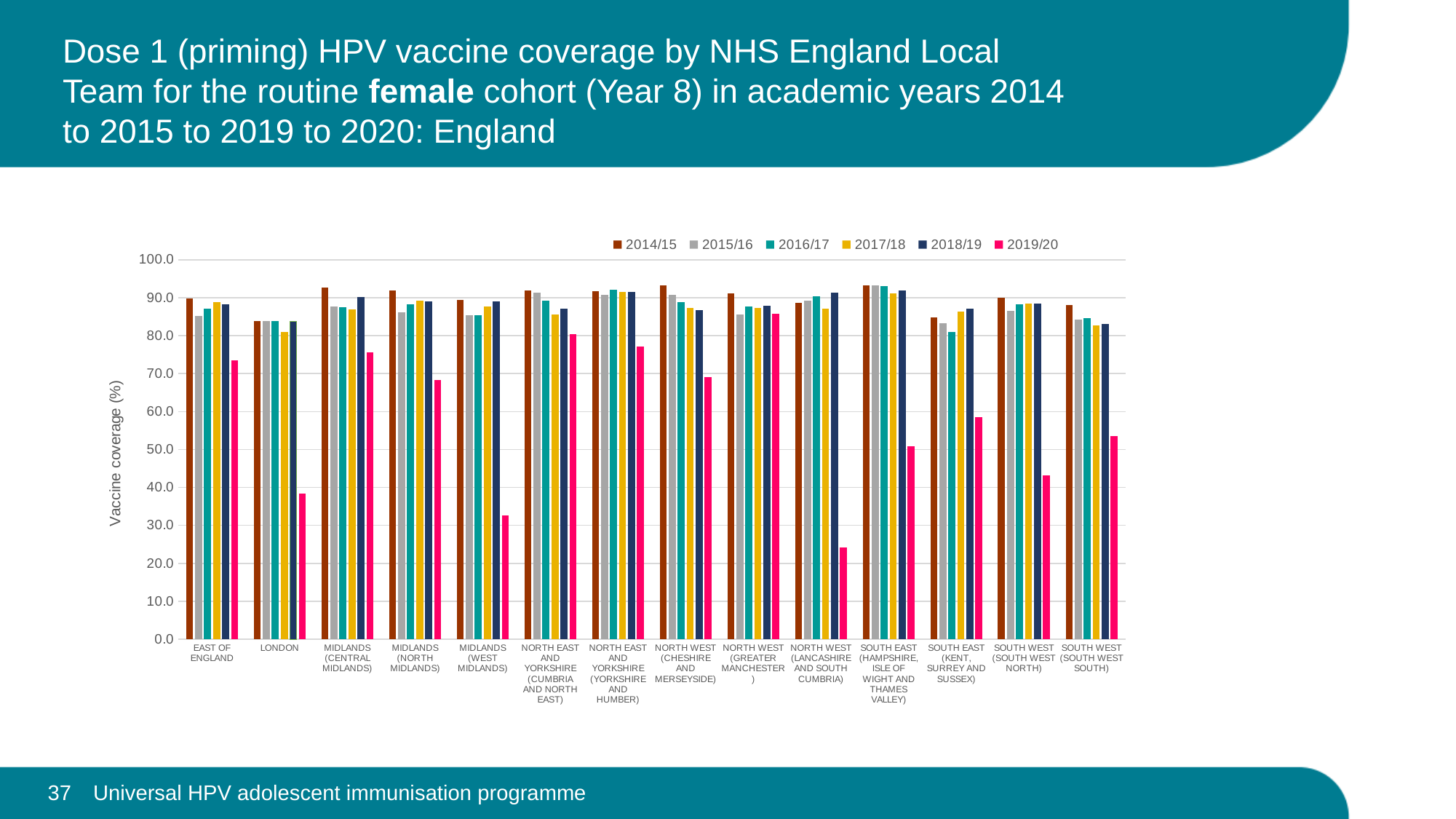
Which is larger for 2019/20: East of England or London? East of England How many NHS England Local Teams are shown along the x axis? 14 Is the 2019/20 value for Midlands (West Midlands) greater or less than 40? less What kind of chart is shown on the slide? bar chart Is the 2019/20 value for London greater or less than 50? less Which Local Team has the highest 2019/20 value? North West (Greater Manchester) Is the 2019/20 value for North West (Lancashire and South Cumbria) greater or less than 30? less Which is larger for 2019/20: Midlands (Central Midlands) or Midlands (West Midlands)? Midlands (Central Midlands) What is the label on the y axis? Vaccine coverage (%) Which Local Team has the lowest 2019/20 value? North West (Lancashire and South Cumbria) How many series does the legend list? 6